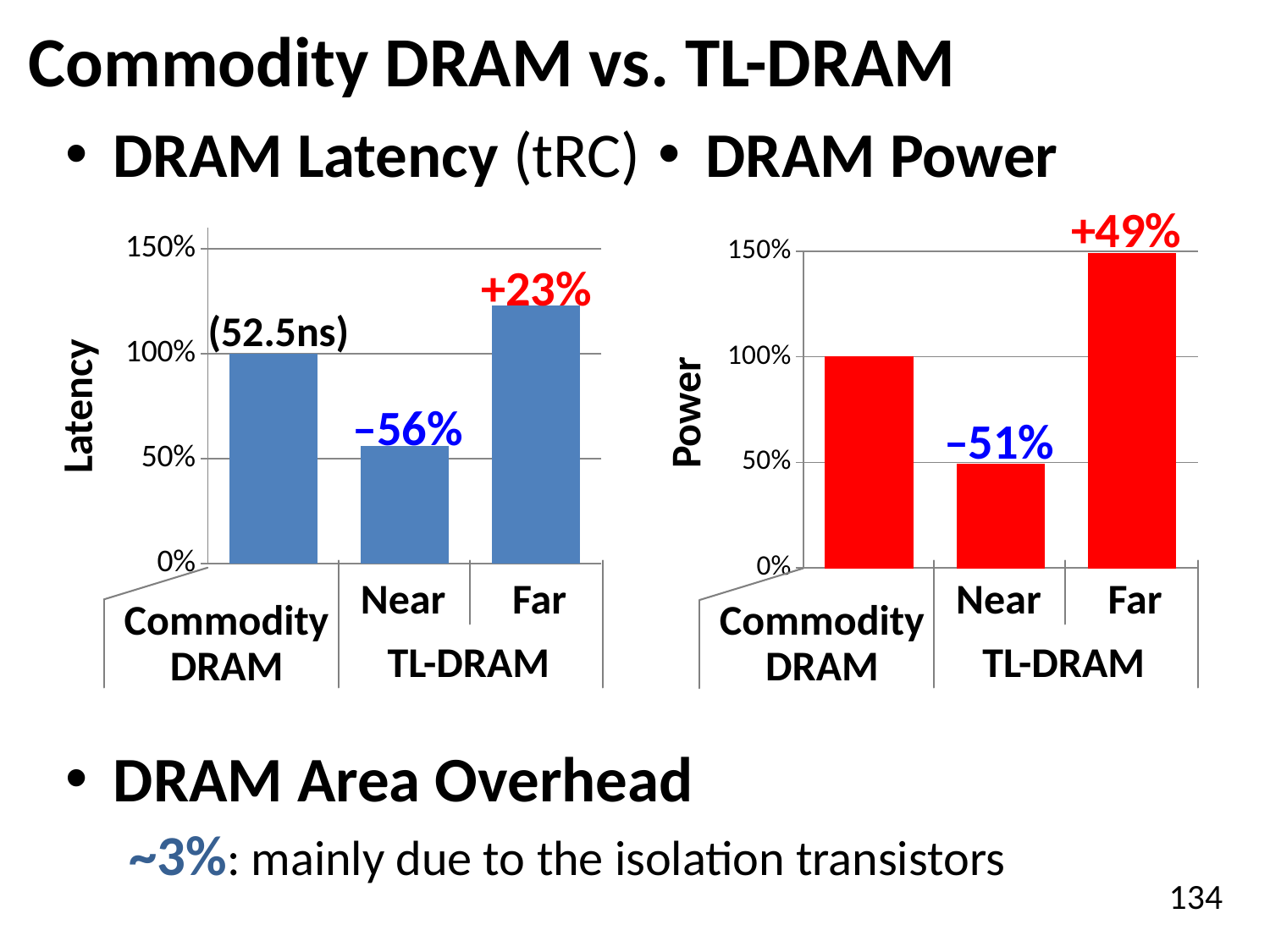
In the DRAM Latency chart, what absolute latency is noted next to the Commodity DRAM bar? (52.5ns) What kind of chart is the DRAM Latency chart? Bar chart In the DRAM Power chart, what percentage change is labelled above the TL-DRAM Near bar? −51% How many bars are plotted in the DRAM Power chart? 3 In the DRAM Latency chart, which bar is the lowest? TL-DRAM Near In the DRAM Latency chart, what is the value of the Commodity DRAM bar? 100% In the DRAM Power chart, which bar is the highest? TL-DRAM Far In the DRAM Latency chart, what percentage change is labelled above the TL-DRAM Far bar? +23% In the DRAM Power chart, is the value for TL-DRAM Far greater or less than 100%? greater In the DRAM Latency chart, what percentage change is labelled above the TL-DRAM Near bar? −56% In the DRAM Power chart, what percentage change is labelled above the TL-DRAM Far bar? +49% In the DRAM Latency chart, is the value for TL-DRAM Near greater or less than 50%? greater